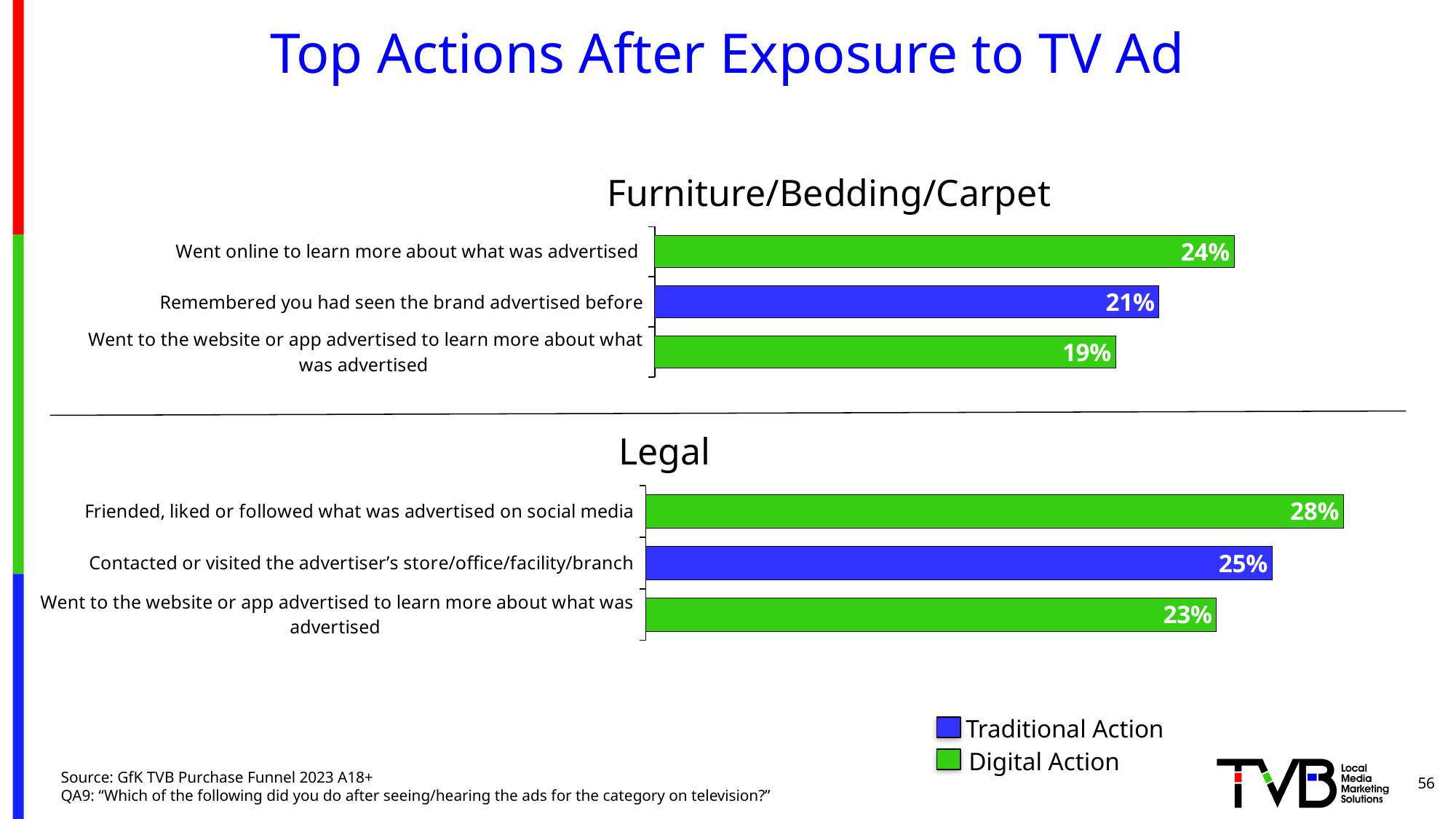
In the Furniture/Bedding/Carpet chart, which action has the lowest value? Went to the website or app advertised to learn more about what was advertised In the Furniture/Bedding/Carpet chart, what is the difference between the values for "Went online to learn more about what was advertised" and "Went to the website or app advertised to learn more about what was advertised"? 5% In the Legal chart, which action has the highest value? Friended, liked or followed what was advertised on social media What type of chart is used for the Furniture/Bedding/Carpet data? Bar chart Which is larger: the value for "Went to the website or app advertised to learn more about what was advertised" in the Legal chart or in the Furniture/Bedding/Carpet chart? Legal In the Legal chart, what is the difference between the values for "Friended, liked or followed what was advertised on social media" and "Went to the website or app advertised to learn more about what was advertised"? 5% In the Furniture/Bedding/Carpet chart, what is the value for "Went online to learn more about what was advertised"? 24% In the Furniture/Bedding/Carpet chart, what is the value for "Remembered you had seen the brand advertised before"? 21% In the Legal chart, what is the value for "Contacted or visited the advertiser's store/office/facility/branch"? 25% In the Legal chart, what is the value for "Friended, liked or followed what was advertised on social media"? 28% How many series does the legend list? 2 How many actions are shown in the Legal chart? 3